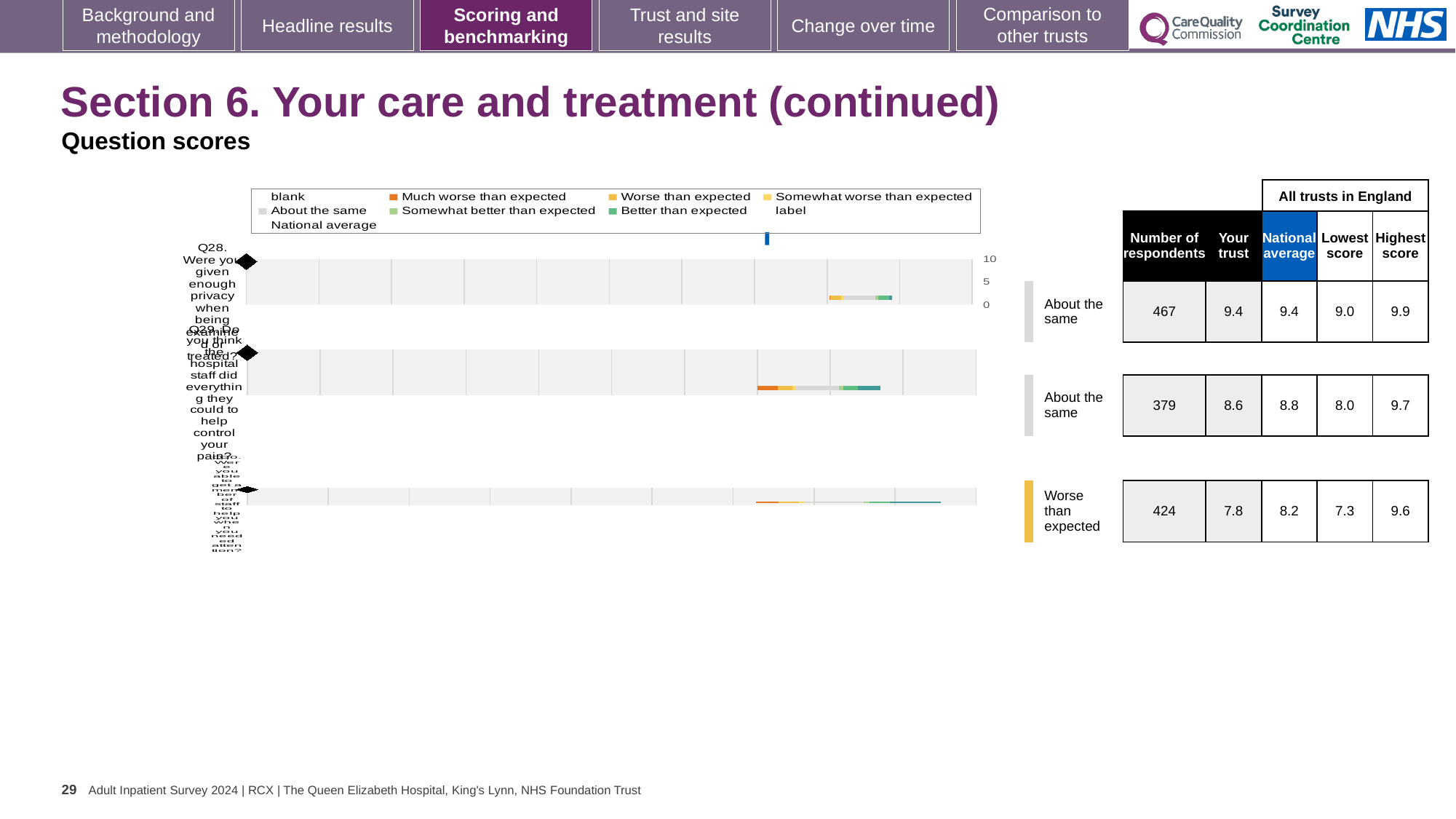
What is the difference between the national average and the 'Your trust' score for Q29? 0.2 What is the national average score for Q29 (Do you think the hospital staff did everything they could to help control your pain?)? 8.8 How many questions are plotted in the chart? 3 What is the highest score across all trusts in England for Q28? 9.9 What benchmark category is shown for Q30? Worse than expected How many respondents answered Q30? 424 What is the 'Your trust' score for Q28 (Were you given enough privacy when being examined or treated?)? 9.4 What kind of chart is used to show the question scores on this slide? bar chart What colour represents 'Much worse than expected' in the legend? orange Which question has the highest 'Your trust' score? Q28 Which question has the lowest 'Your trust' score? Q30 Which has the larger 'Your trust' score, Q28 or Q29? Q28